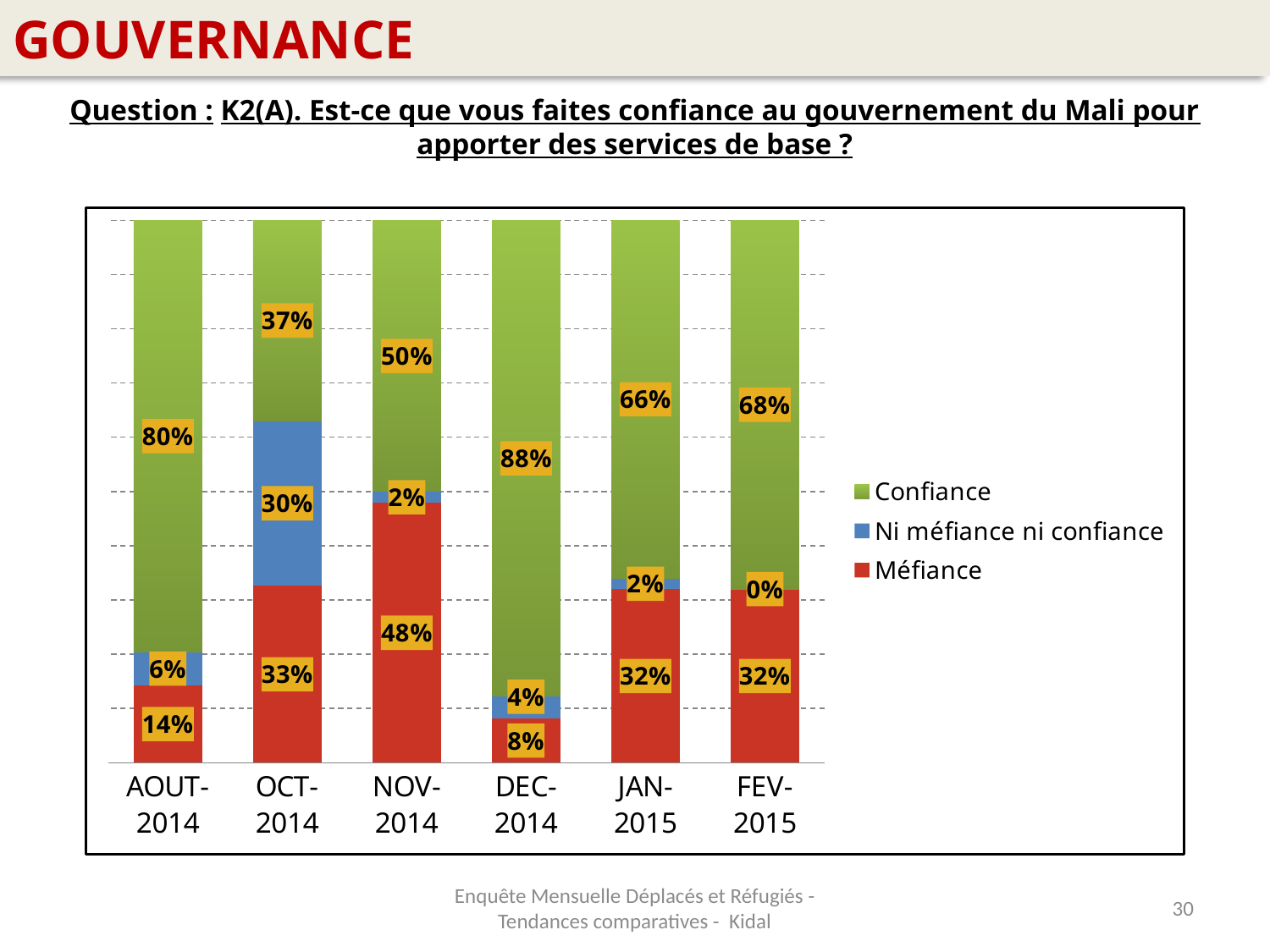
How many series does the legend list? 3 What is the 'Ni méfiance ni confiance' value for OCT-2014? 30% What is the Confiance value for DEC-2014? 88% Which month has the lowest Méfiance value? DEC-2014 Which month has the highest Confiance value? DEC-2014 What kind of chart is shown on the slide? stacked bar chart What is the Méfiance value for NOV-2014? 48% How many months are shown on the x axis? 6 What is the difference between the Confiance values for FEV-2015 and JAN-2015? 2% Which legend entry is shown in green? Confiance Which is larger, the Méfiance value for OCT-2014 or for AOUT-2014? OCT-2014 What is the total of the stacked bar for OCT-2014? 100%